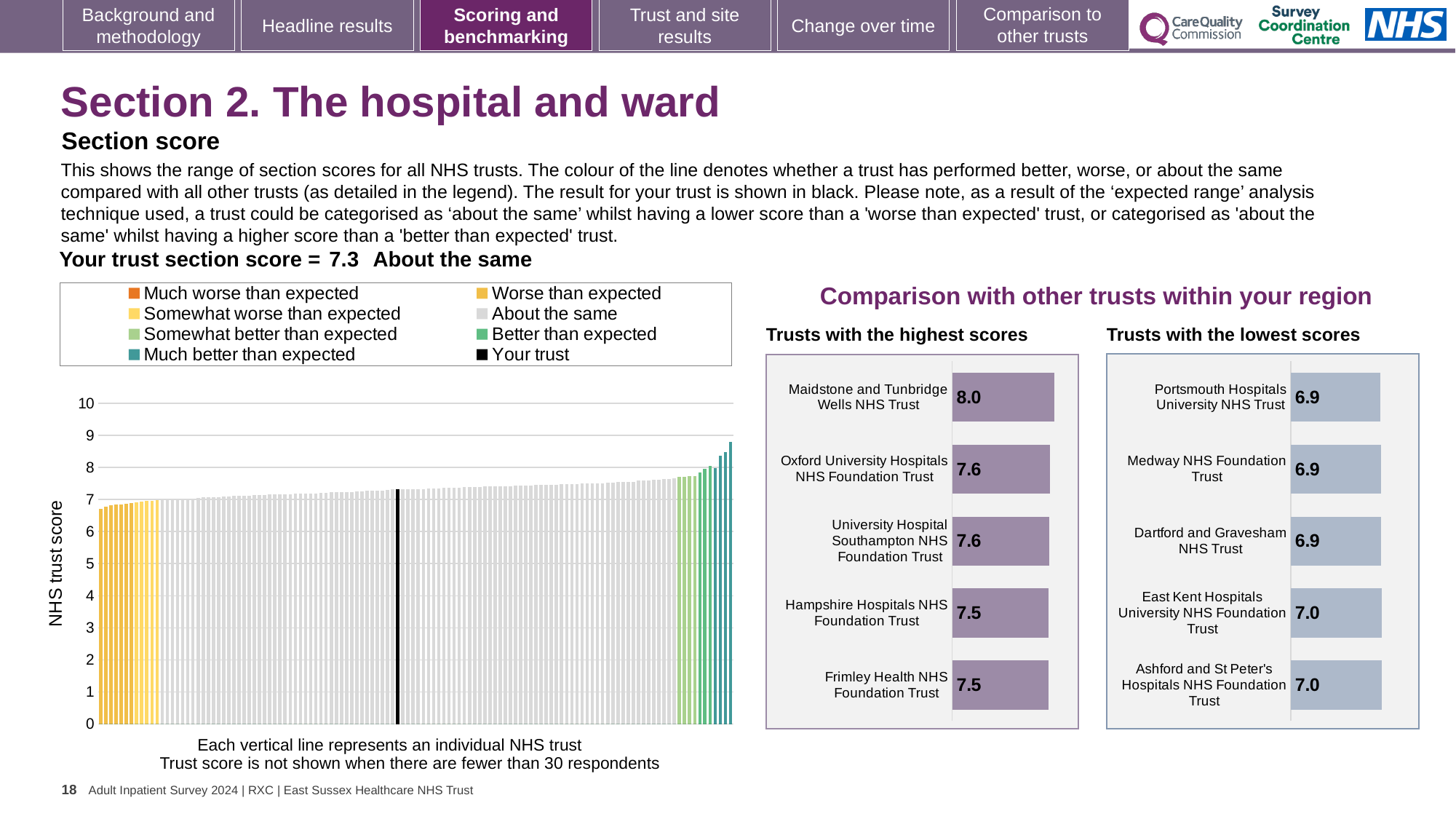
In the 'Trusts with the lowest scores' chart, what is the score for East Kent Hospitals University NHS Foundation Trust? 7.0 Which is larger: the score for Oxford University Hospitals NHS Foundation Trust in the highest-scores chart or the score for Medway NHS Foundation Trust in the lowest-scores chart? Oxford University Hospitals NHS Foundation Trust In the 'Trusts with the lowest scores' chart, what is the score for Portsmouth Hospitals University NHS Trust? 6.9 What kind of chart is the main chart on the left showing NHS trust scores? Bar chart In the main chart on the left, how many entries does the legend list? 8 In the main chart on the left, is the value of the leftmost (lowest) bar greater or less than 7? less In the 'Trusts with the highest scores' chart, what is the score for Maidstone and Tunbridge Wells NHS Trust? 8.0 In the 'Trusts with the highest scores' chart, what is the difference between the scores of Maidstone and Tunbridge Wells NHS Trust and Frimley Health NHS Foundation Trust? 0.5 In the 'Trusts with the highest scores' chart, what is the score for Hampshire Hospitals NHS Foundation Trust? 7.5 How many trusts are shown in the 'Trusts with the lowest scores' chart? 5 In the 'Trusts with the highest scores' chart, which trust has the highest score? Maidstone and Tunbridge Wells NHS Trust In the main chart on the left, do the trust scores rise or fall from left to right? Rise